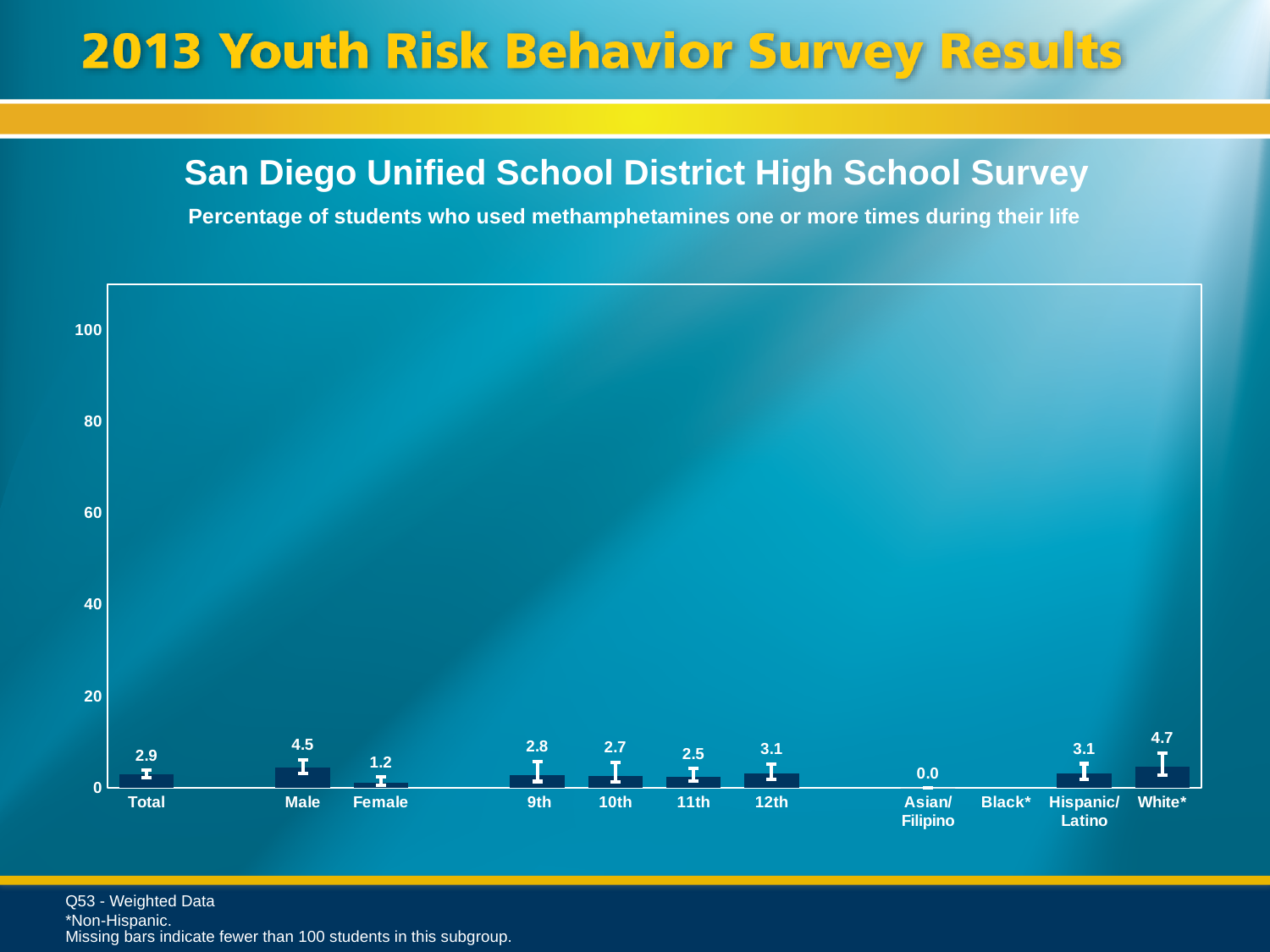
What is the value for Total? 2.9 What kind of chart is shown? bar chart What is the value for 12th grade? 3.1 What is the value for Asian/Filipino? 0.0 Which grade level has the lowest value? 11th What is the value for Male? 4.5 What does the chart subtitle say is being measured? Percentage of students who used methamphetamines one or more times during their life What is the value for Female? 1.2 Which category with a plotted bar has the highest value? White* Which is larger, the value for 9th grade or 10th grade? 9th Is the value for Male greater or less than 20? less What is the difference between the Male and Female values? 3.3